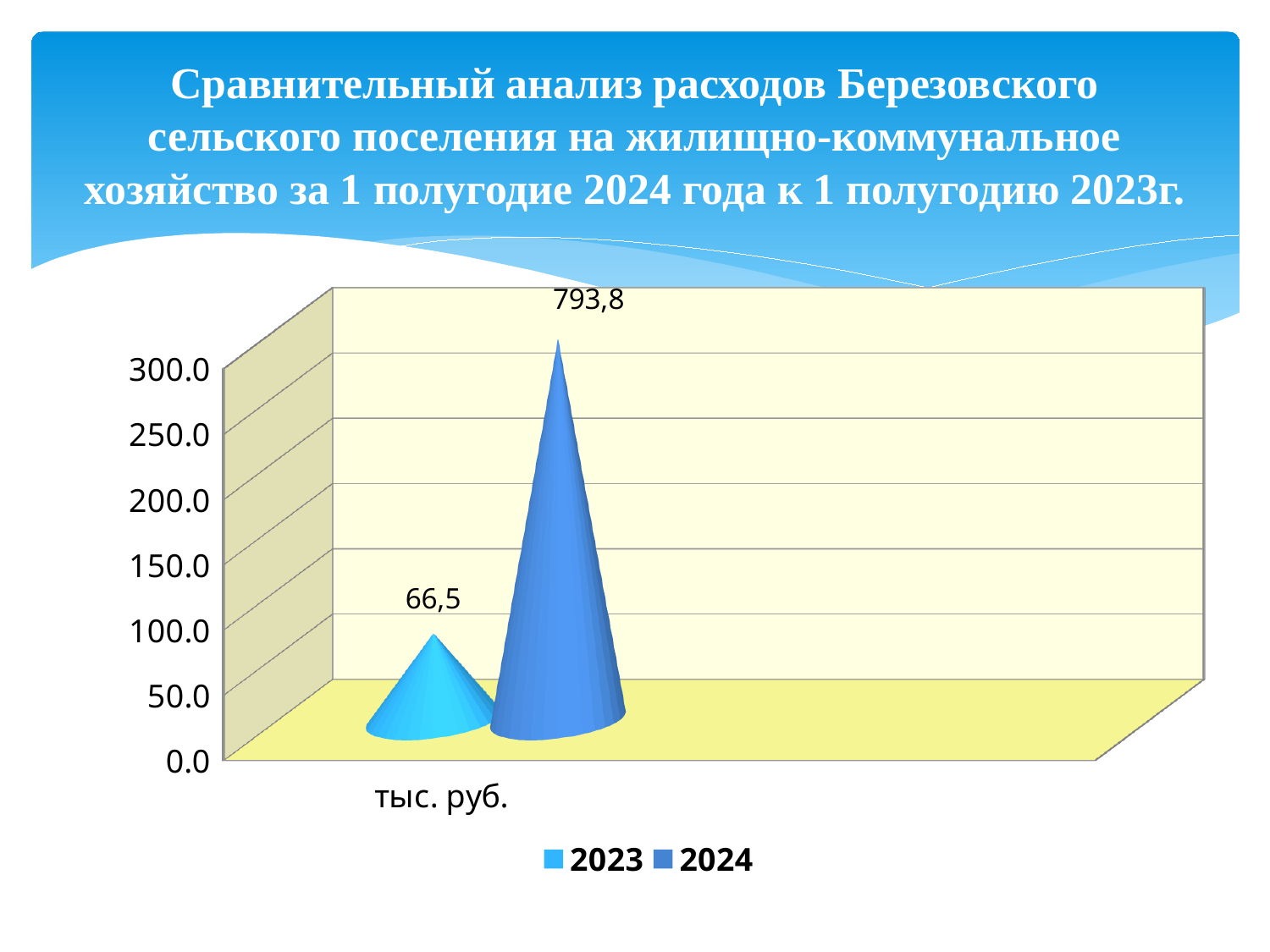
Is the value for 2023 greater or less than 50? greater Which series has the higher value, 2023 or 2024? 2024 What is the highest value shown on the vertical axis of the chart? 300.0 How many series does the legend list? 2 Is the value for 2023 greater or less than 100? less What kind of chart is shown on the slide? bar chart Which series has the highest value on the chart? 2024 What is the category label shown on the x axis of the chart? тыс. руб. What is the difference between the 2024 value and the 2023 value? 727,3 What is the value for 2024 on the chart? 793,8 Which series has the lowest value on the chart? 2023 What is the value for 2023 on the chart? 66,5